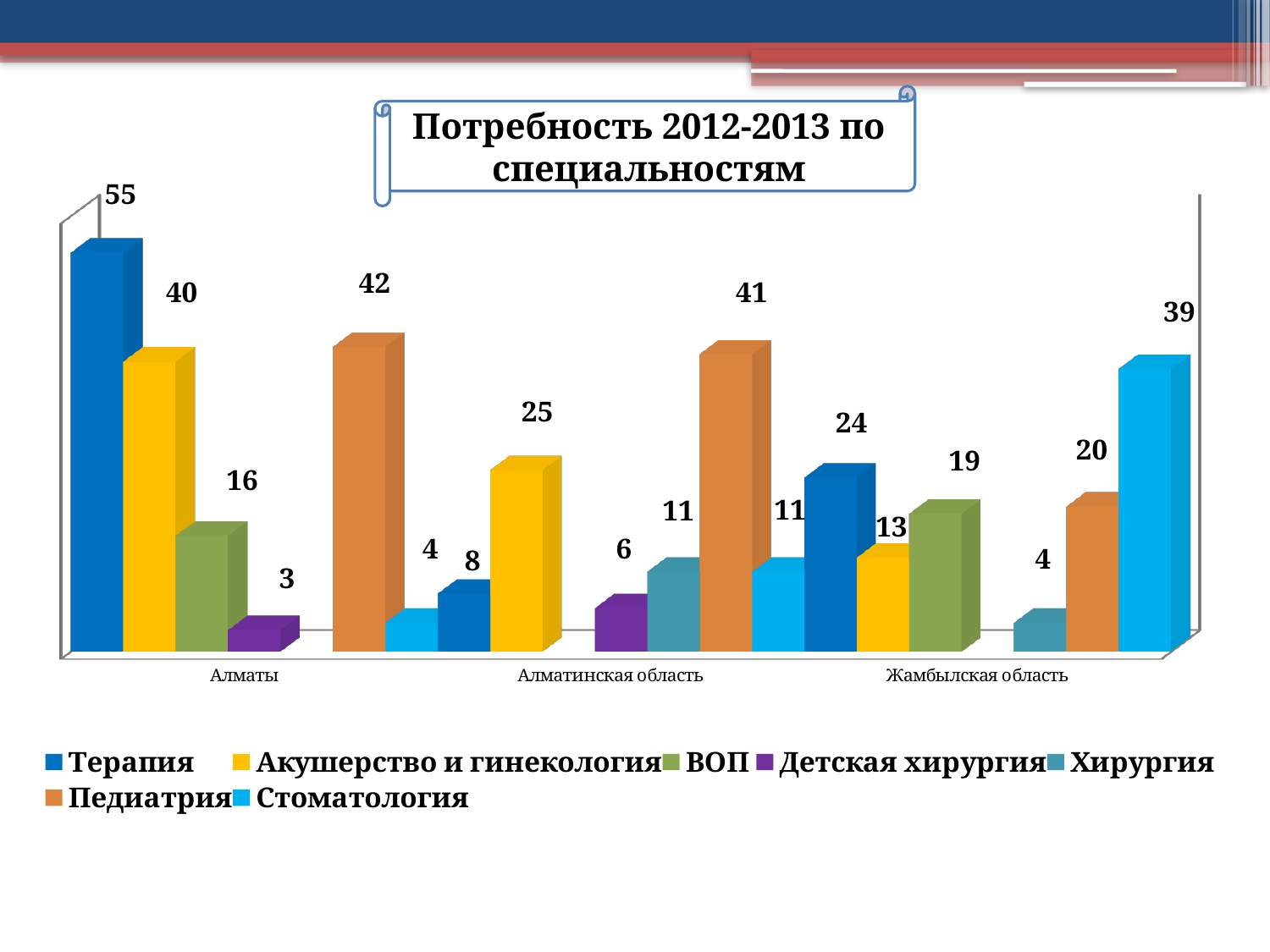
How many series does the legend list? 7 What is the value for Стоматология in Жамбылская область? 39 What is the difference between Терапия and Акушерство и гинекология in Алматы? 15 Which is larger in Алматинская область: Педиатрия or Акушерство и гинекология? Педиатрия Which series has the highest value in Жамбылская область? Стоматология What is the value for Терапия in Алматы? 55 What is the value for Педиатрия in Алматинская область? 41 What kind of chart is shown on the slide? Bar chart What is the title of the chart? Потребность 2012-2013 по специальностям How many categories (regions) are shown on the x axis? 3 Which series has the lowest value in Алматы? Детская хирургия What is the value for ВОП in Жамбылская область? 19